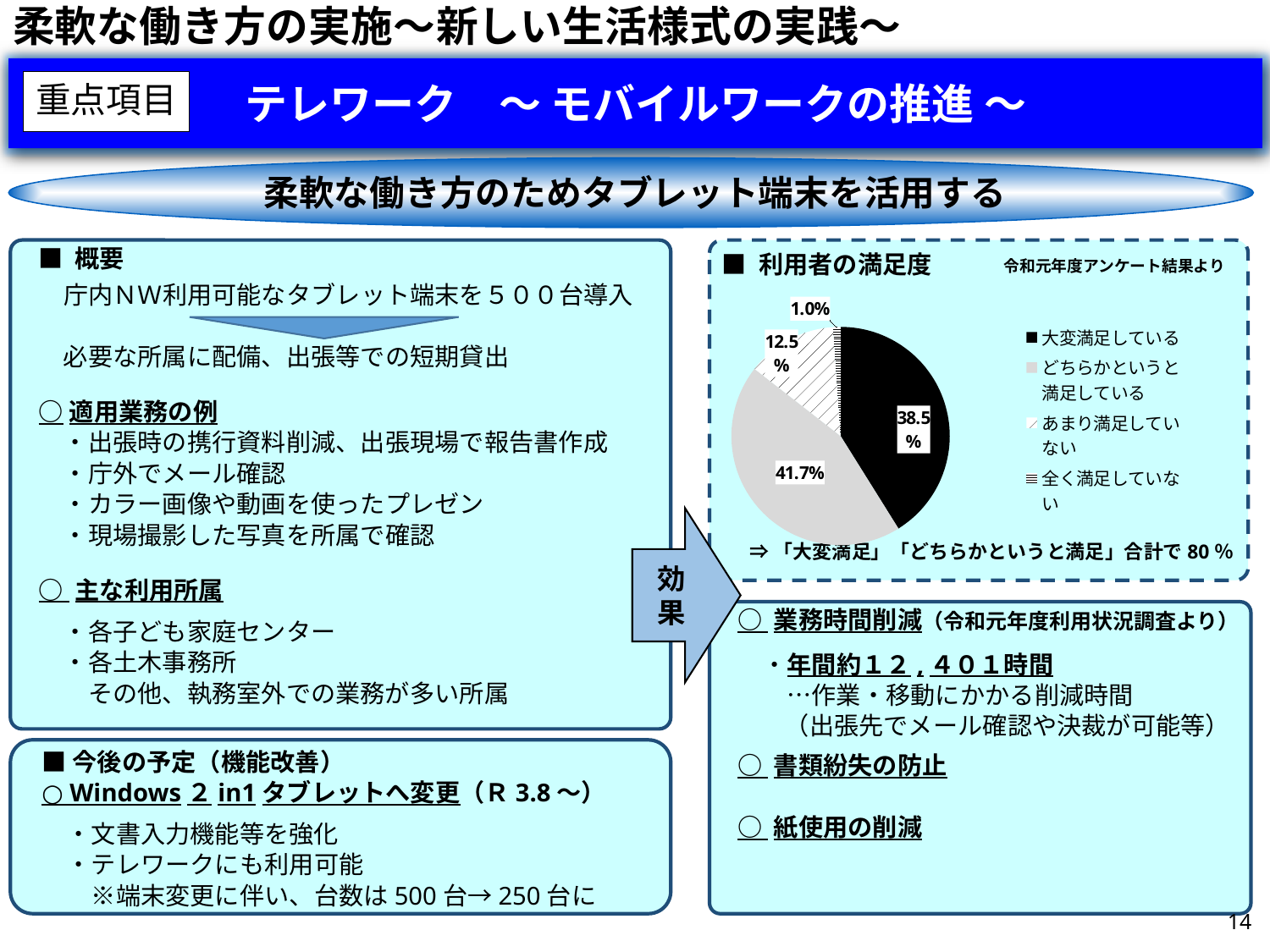
「利用者の満足度」の円グラフで、「あまり満足していない」の割合はいくつですか？ 12.5% 「利用者の満足度」の円グラフで、「どちらかというと満足している」の割合はいくつですか？ 41.7% 「利用者の満足度」の円グラフで、最も割合が小さい項目はどれですか？ 全く満足していない 「利用者の満足度」のグラフはどの種類のグラフですか？ 円グラフ 「利用者の満足度」の円グラフには、いくつの項目（区分）がありますか？ 4 「利用者の満足度」の円グラフの凡例には、いくつの項目が記載されていますか？ 4 「利用者の満足度」の円グラフで、最も割合が大きい項目はどれですか？ どちらかというと満足している 「利用者の満足度」の円グラフで、「大変満足している」の割合はいくつですか？ 38.5% 「利用者の満足度」の円グラフで、「全く満足していない」の割合はいくつですか？ 1.0% 「利用者の満足度」の円グラフで、「大変満足している」と「あまり満足していない」ではどちらの割合が大きいですか？ 大変満足している 「利用者の満足度」の円グラフで、「どちらかというと満足している」と「大変満足している」の割合の差はいくつですか？ 3.2% 「利用者の満足度」の円グラフで、「大変満足している」と「どちらかというと満足している」の合計はいくつですか？ 80.2%